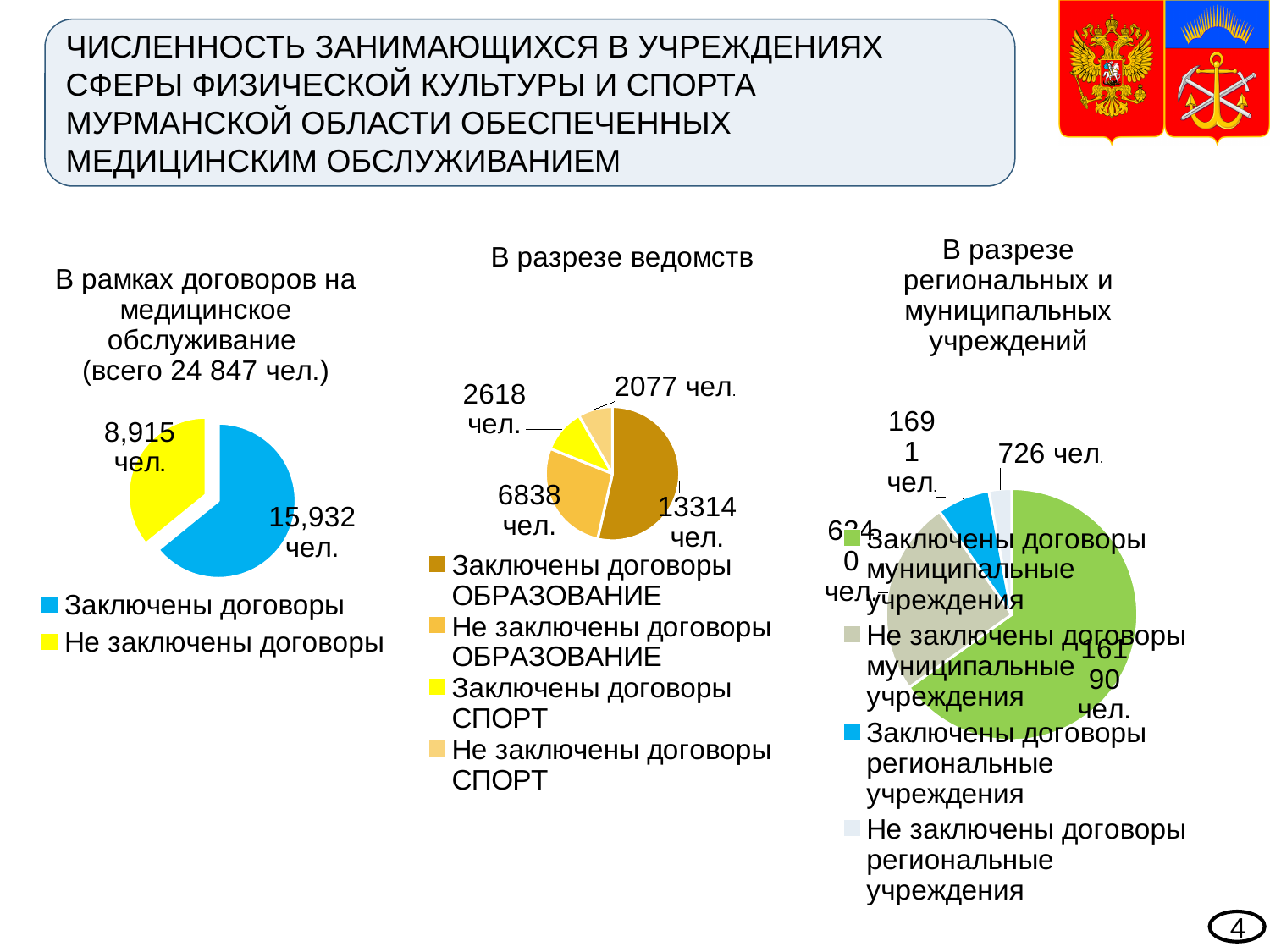
On the left pie chart 'В рамках договоров на медицинское обслуживание', how many slices does the pie have? 2 On the left pie chart 'В рамках договоров на медицинское обслуживание', what is the value for 'Заключены договоры'? 15,932 чел. On the right pie chart 'В разрезе региональных и муниципальных учреждений', which category has the largest value? Заключены договоры муниципальные учреждения On the middle pie chart 'В разрезе ведомств', which is larger: 'Не заключены договоры ОБРАЗОВАНИЕ' or 'Заключены договоры СПОРТ'? Не заключены договоры ОБРАЗОВАНИЕ On the middle pie chart 'В разрезе ведомств', what is the value for 'Заключены договоры ОБРАЗОВАНИЕ'? 13314 чел. On the left pie chart 'В рамках договоров на медицинское обслуживание', what is the value for 'Не заключены договоры'? 8,915 чел. On the middle pie chart 'В разрезе ведомств', what is the value for 'Не заключены договоры СПОРТ'? 2077 чел. On the middle pie chart 'В разрезе ведомств', which category has the smallest value? Не заключены договоры СПОРТ On the left pie chart 'В рамках договоров на медицинское обслуживание', what is the difference between 'Заключены договоры' and 'Не заключены договоры'? 7,017 чел. On the right pie chart 'В разрезе региональных и муниципальных учреждений', what is the value for 'Не заключены договоры региональные учреждения'? 726 чел. On the middle pie chart 'В разрезе ведомств', how many entries does the legend list? 4 What type of chart is used for 'В разрезе ведомств' in the middle of the slide? Pie chart